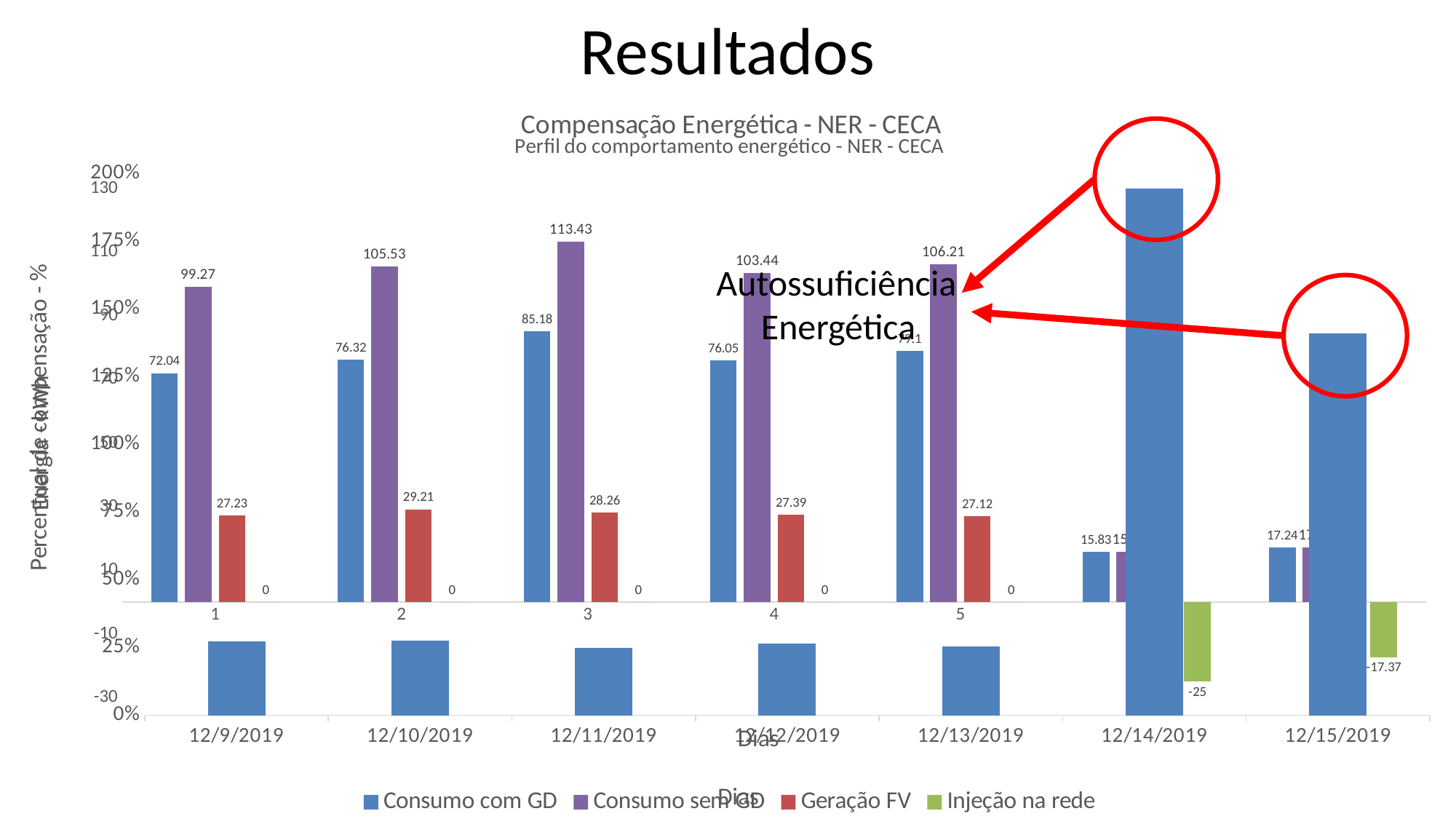
In the 'Perfil do comportamento energético - NER - CECA' chart, what is the value of Geração FV for day 2? 29.21 What kind of chart is 'Compensação Energética - NER - CECA'? bar chart In the 'Compensação Energética - NER - CECA' chart, is the value for 12/9/2019 greater or less than 50%? less In the 'Perfil do comportamento energético - NER - CECA' chart, what is the value of Consumo sem GD for day 3? 113.43 In the 'Perfil do comportamento energético - NER - CECA' chart, what is the value of Consumo com GD for day 1? 72.04 In the 'Perfil do comportamento energético - NER - CECA' chart, which day has the lowest Consumo com GD value among days 1 to 5? 1 How many series does the legend at the bottom of the slide list? 4 How many dates are shown on the x axis of the 'Compensação Energética - NER - CECA' chart? 7 In the 'Perfil do comportamento energético - NER - CECA' chart, which is larger for day 4: Consumo sem GD or Consumo com GD? Consumo sem GD In the 'Compensação Energética - NER - CECA' chart, is the value for 12/14/2019 greater or less than 175%? greater In the 'Perfil do comportamento energético - NER - CECA' chart, which day has the highest Consumo sem GD value among days 1 to 5? 3 In the 'Perfil do comportamento energético - NER - CECA' chart, what is the difference between Consumo sem GD and Consumo com GD for day 3? 28.25